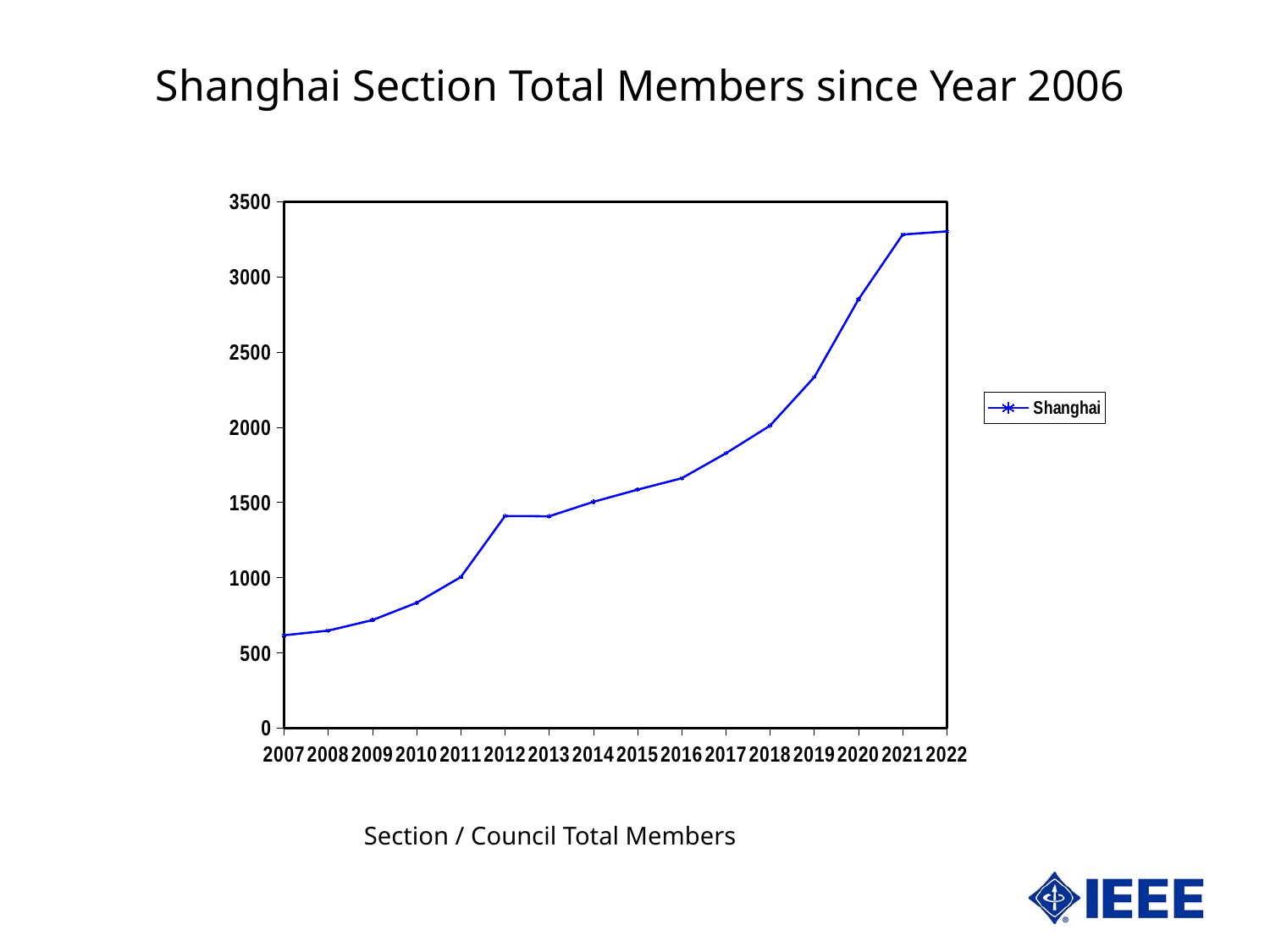
Is the value for 2007 greater or less than 1000? less Which year has the larger value, 2015 or 2020? 2020 Is the value for 2020 greater or less than 2500? greater What is the name of the series shown in the legend? Shanghai What kind of chart is shown on the slide? line chart Which year has the lowest number of members? 2007 Is the value for 2021 greater or less than 3000? greater How many series does the legend list? 1 Do the values generally rise or fall from 2007 to 2022? rise How many years are plotted along the x axis? 16 What is the title of the chart? Shanghai Section Total Members since Year 2006